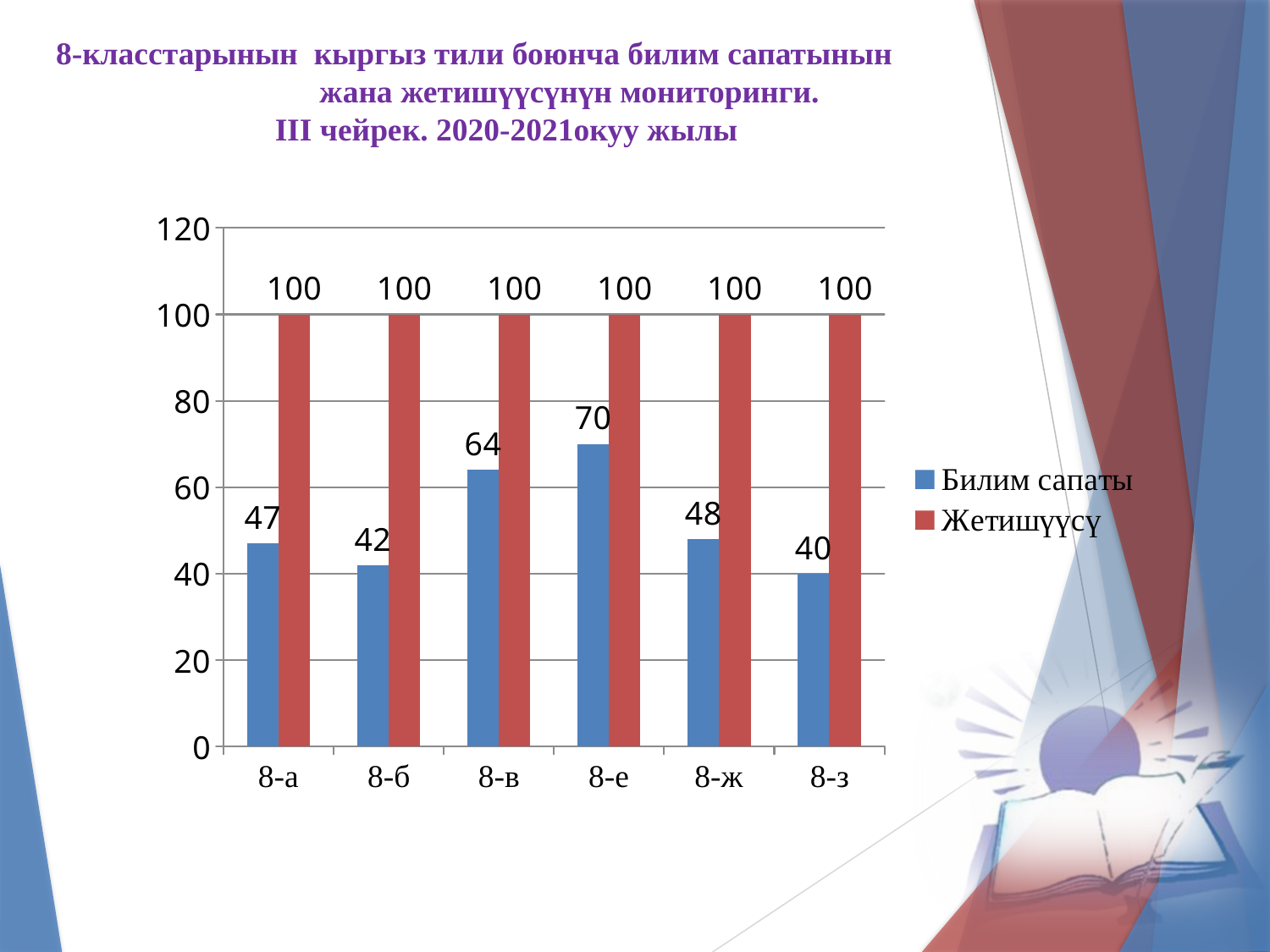
Which class has the highest Билим сапаты value? 8-е What is the Жетишүүсү value for 8-б? 100 What kind of chart is shown on the slide? bar chart Which class has the lowest Билим сапаты value? 8-з What is the Билим сапаты value for 8-в? 64 How many series does the legend list? 2 Which is larger, the Билим сапаты value for 8-а or for 8-ж? 8-ж What is the difference between the Билим сапаты values for 8-е and 8-б? 28 Is the Билим сапаты value for 8-в greater or less than 60? greater What is the Билим сапаты value for 8-з? 40 What colour are the Жетишүүсү bars? red How many classes are shown on the x axis? 6